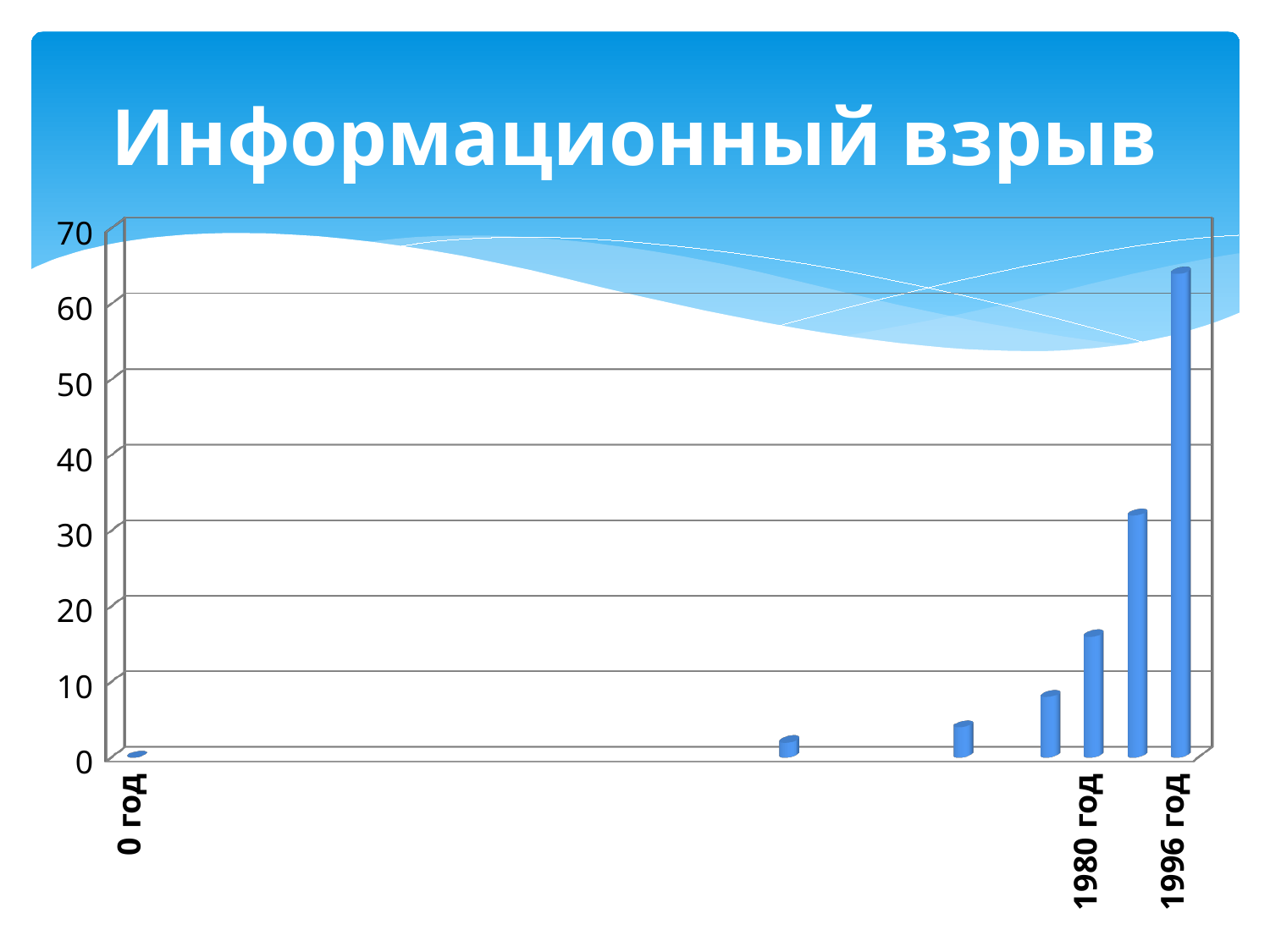
Is the value for 1996 год greater or less than 60? greater Is the value for 1980 год greater or less than 20? less Which category has the highest bar? 1996 год Is the value for 1980 год greater or less than 10? greater Which is larger, the value for 1980 год or the value for 1996 год? 1996 год What is the title of the chart on the slide? Информационный взрыв Do the bar values rise or fall from left to right along the x axis? rise What kind of chart is shown on the slide? bar chart Which labelled category has the lowest bar? 0 год How many bars are plotted on the chart? 7 What is the highest value shown on the vertical axis? 70